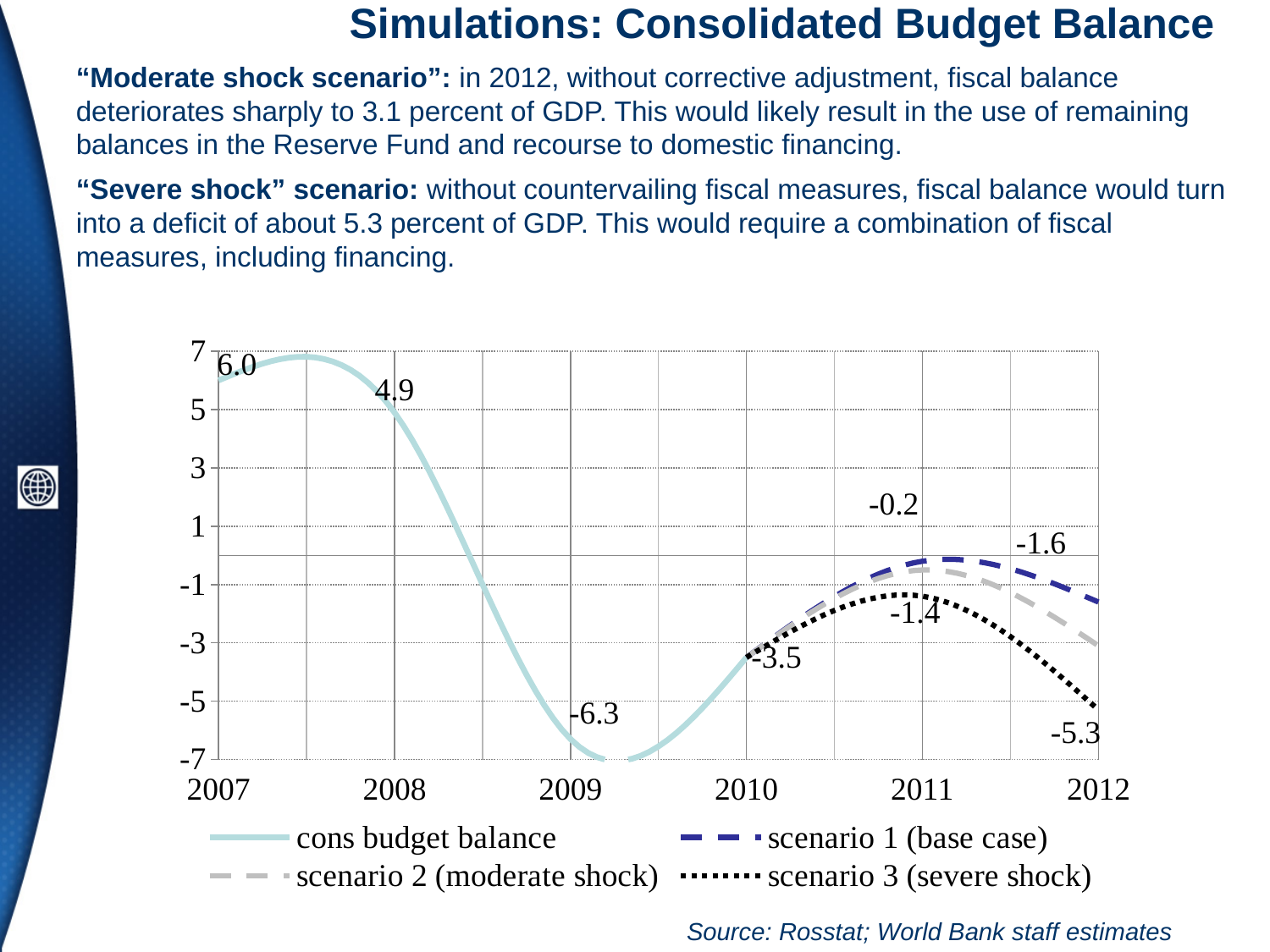
What is the value of the cons budget balance in 2010? -3.5 What is the value of scenario 3 (severe shock) in 2012? -5.3 What kind of chart is shown on the slide? line chart By how much did the cons budget balance fall from 2007 to 2008? 1.1 Is the value for scenario 2 (moderate shock) in 2012 greater or less than -1? less What is the value of the cons budget balance in 2008? 4.9 What is the value of the cons budget balance in 2007? 6.0 What is the value of the cons budget balance in 2009? -6.3 Which is higher in 2012: scenario 1 (base case) or scenario 3 (severe shock)? scenario 1 (base case) In which year is the cons budget balance at its highest? 2007 In which year is the cons budget balance at its lowest? 2009 How many series does the chart legend list? 4